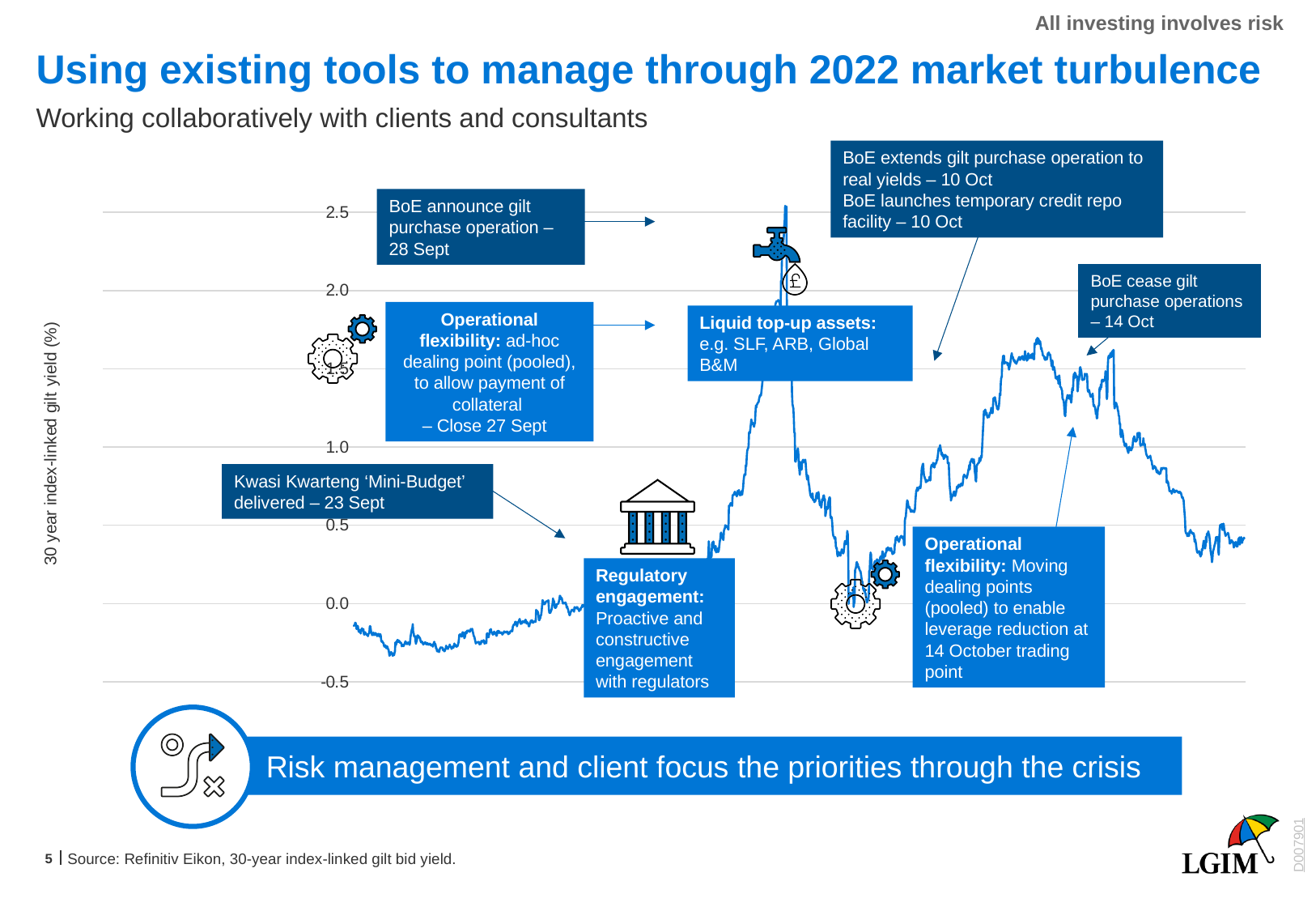
Is the lowest point of the plotted line greater or less than -0.5? greater Is the yield at the right end of the plotted line greater or less than 0.0? greater Is the highest point of the plotted line greater or less than 2.0? greater Comparing the left end of the line to the right end, does the yield rise or fall overall across the chart? rise What is the label on the vertical axis of the chart? 30 year index-linked gilt yield (%) How many data series are plotted on the chart? 1 Is the yield at the right end of the line higher or lower than at the left end? higher What is the highest value shown on the vertical axis of the chart? 2.5 What kind of chart is shown on the slide? line chart